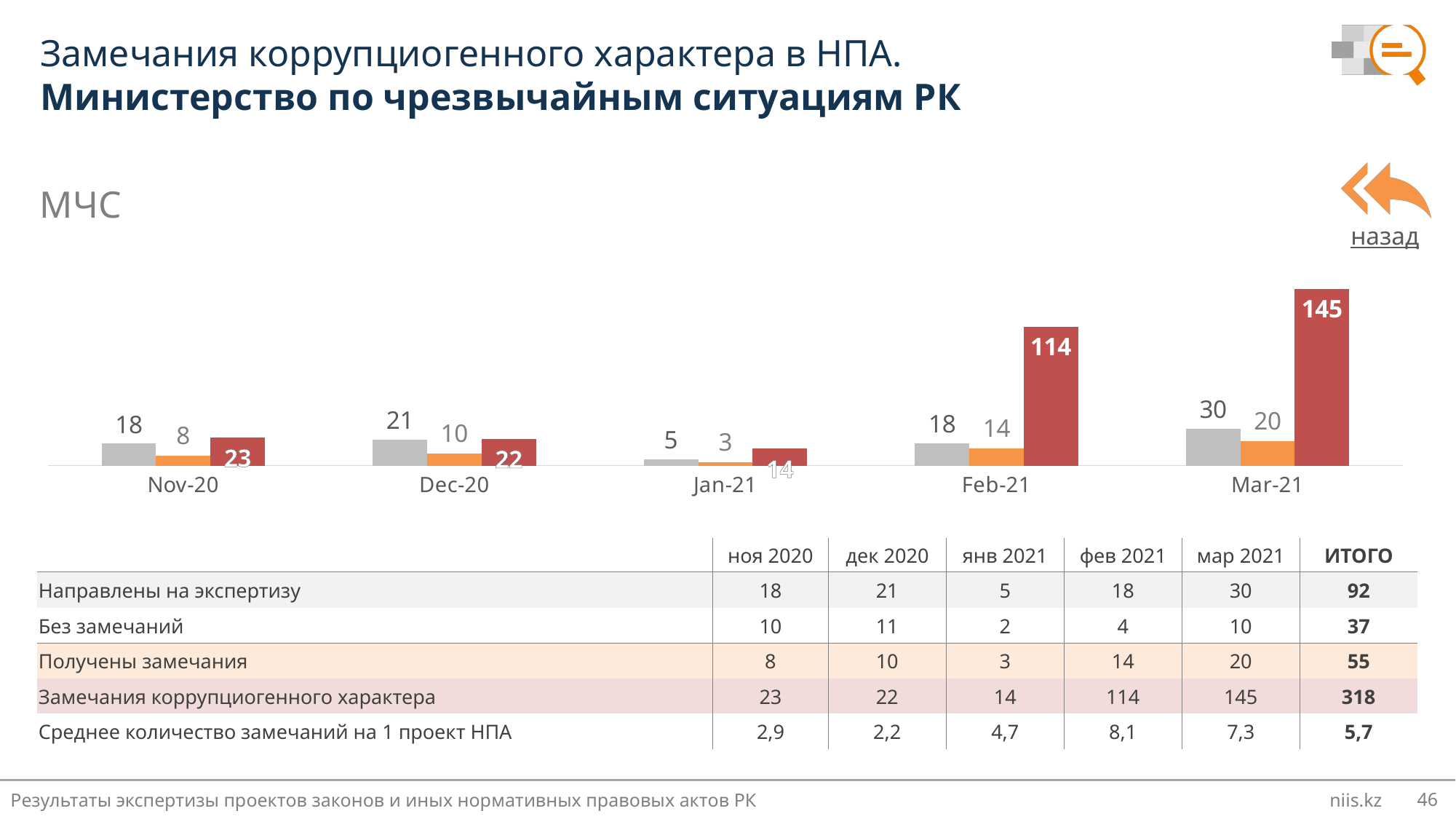
What is the difference between the red bar values for Mar-21 and Feb-21? 31 What is the value of the orange bar (Получены замечания) for Feb-21? 14 What colour are the bars representing Замечания коррупциогенного характера in the chart? red What is the value of the red bar (Замечания коррупциогенного характера) for Mar-21? 145 What is the value of the grey bar (Направлены на экспертизу) for Dec-20? 21 In which month is the grey bar (Направлены на экспертизу) lowest? Jan-21 What is the difference between the grey bar values for Mar-21 and Nov-20? 12 Which is larger for Nov-20: the grey bar (18) or the orange bar (8)? the grey bar (18) Does the red bar (Замечания коррупциогенного характера) rise or fall from Jan-21 to Mar-21? rise In which month does the red bar (Замечания коррупциогенного характера) reach its highest value? Mar-21 How many months (categories) are shown on the x axis of the chart? 5 What type of chart is shown on the slide? bar chart